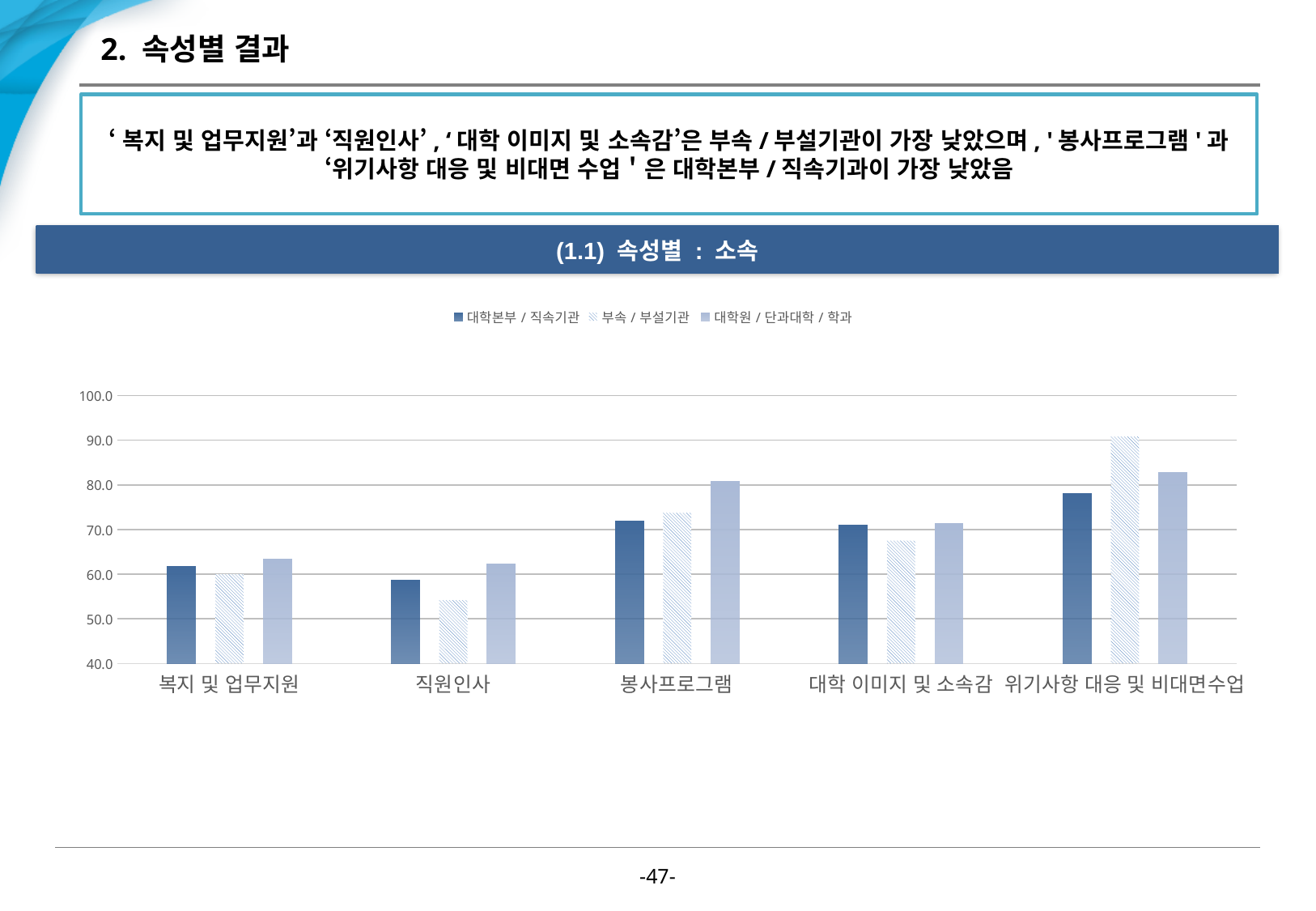
Which series has the highest value in the 위기사항 대응 및 비대면수업 category? 부속 / 부설기관 In which category is the 대학본부 / 직속기관 value lowest? 직원인사 Is the value for 부속 / 부설기관 in 위기사항 대응 및 비대면수업 greater or less than 80? greater Is the value for 부속 / 부설기관 in 대학 이미지 및 소속감 greater or less than 70? less What kind of chart is shown on the slide? bar chart What is the title shown in the blue banner above the chart? (1.1) 속성별 : 소속 How many series does the legend list? 3 Is the value for 부속 / 부설기관 in 직원인사 greater or less than 60? less Which series has the lowest value in the 직원인사 category? 부속 / 부설기관 How many categories are shown on the x axis? 5 In the 봉사프로그램 category, which is larger: 대학본부 / 직속기관 or 대학원 / 단과대학 / 학과? 대학원 / 단과대학 / 학과 In which category is the 대학본부 / 직속기관 value highest? 위기사항 대응 및 비대면수업